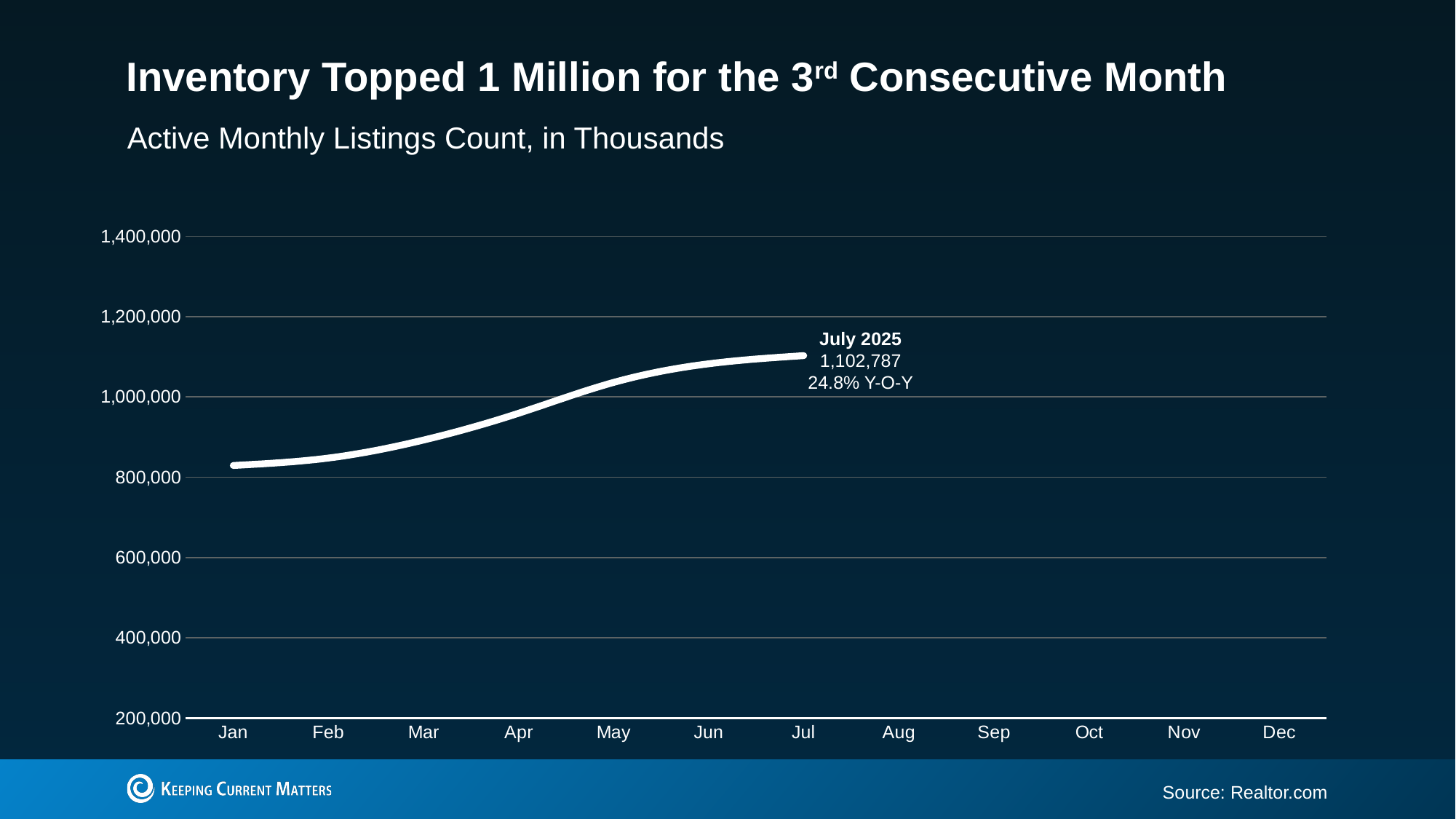
Which month has the highest plotted value? Jul Which month has the lowest plotted value? Jan Is the value for Jun greater or less than 1,000,000? greater Is the value for Jan greater or less than 800,000? greater Is the value for Jan greater or less than 1,000,000? less What is the subtitle describing the chart's data? Active Monthly Listings Count, in Thousands Do the plotted values rise or fall from Jan to Jul? Rise What year-over-year change is labeled for July 2025? 24.8% Y-O-Y How many month labels appear on the x axis? 12 What kind of chart is shown on the slide? Line chart What is the active listings count shown for July 2025? 1,102,787